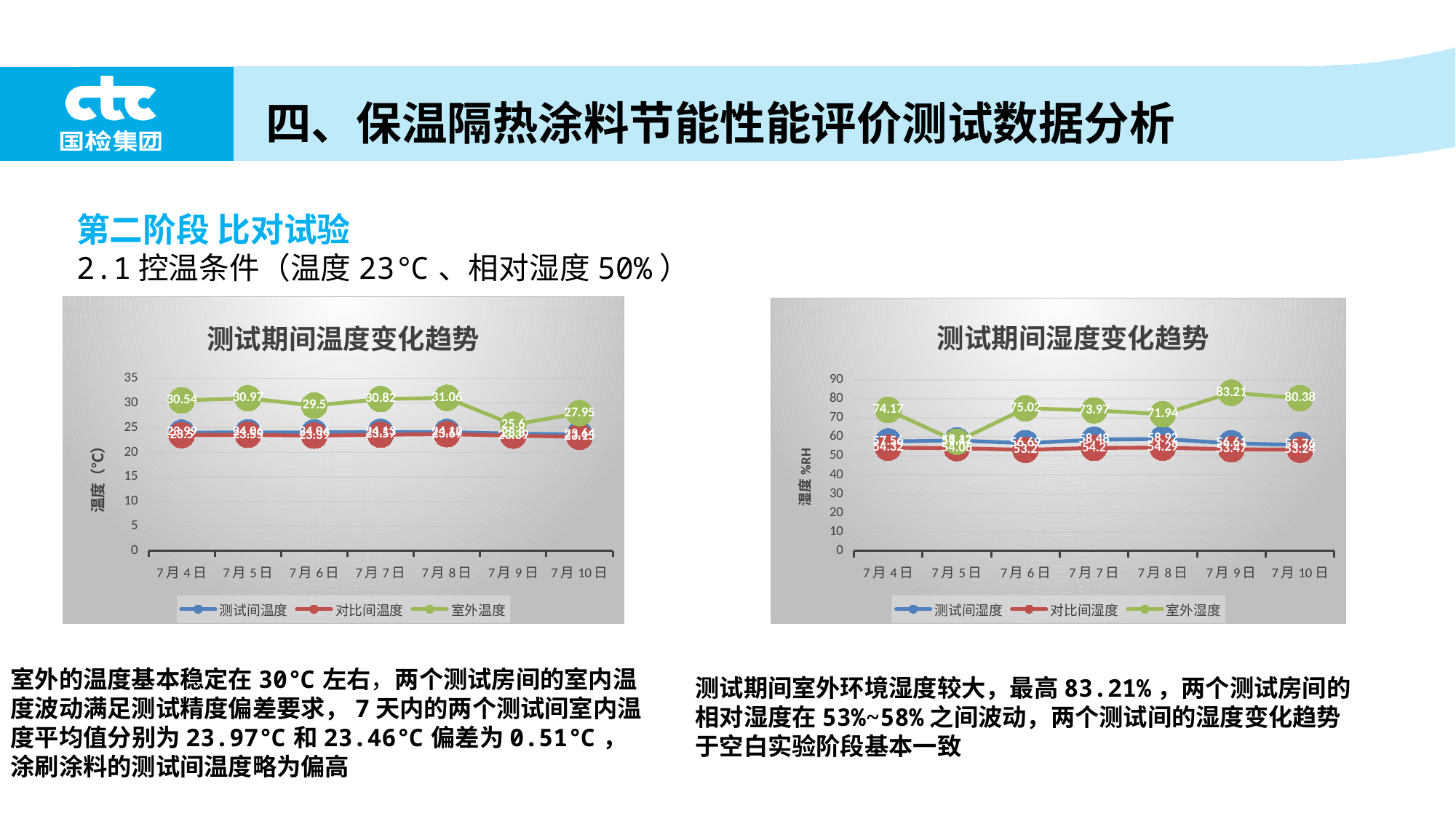
What type of chart is the 测试期间温度变化趋势 chart? line chart In the 测试期间温度变化趋势 chart, what is the difference between the 室外温度 on 7月5日 and on 7月6日? 1.47 In the 测试期间湿度变化趋势 chart, is the 室外湿度 value on 7月10日 greater or less than 70? greater In the 测试期间温度变化趋势 chart, on which date is 室外温度 lowest? 7月9日 How many dates are shown on the x axis of the 测试期间温度变化趋势 chart? 7 How many series does the legend of the 测试期间湿度变化趋势 chart list? 3 In the 测试期间温度变化趋势 chart, what is the 室外温度 value on 7月8日? 31.06 In the 测试期间湿度变化趋势 chart, which is larger: the 室外湿度 on 7月6日 or on 7月8日? 7月6日 In the 测试期间温度变化趋势 chart, on which date is 室外温度 highest? 7月8日 In the 测试期间温度变化趋势 chart, what is the 室外温度 value on 7月9日? 25.6 In the 测试期间湿度变化趋势 chart, on which date is 室外湿度 lowest? 7月5日 In the 测试期间湿度变化趋势 chart, what is the 室外湿度 value on 7月9日? 83.21